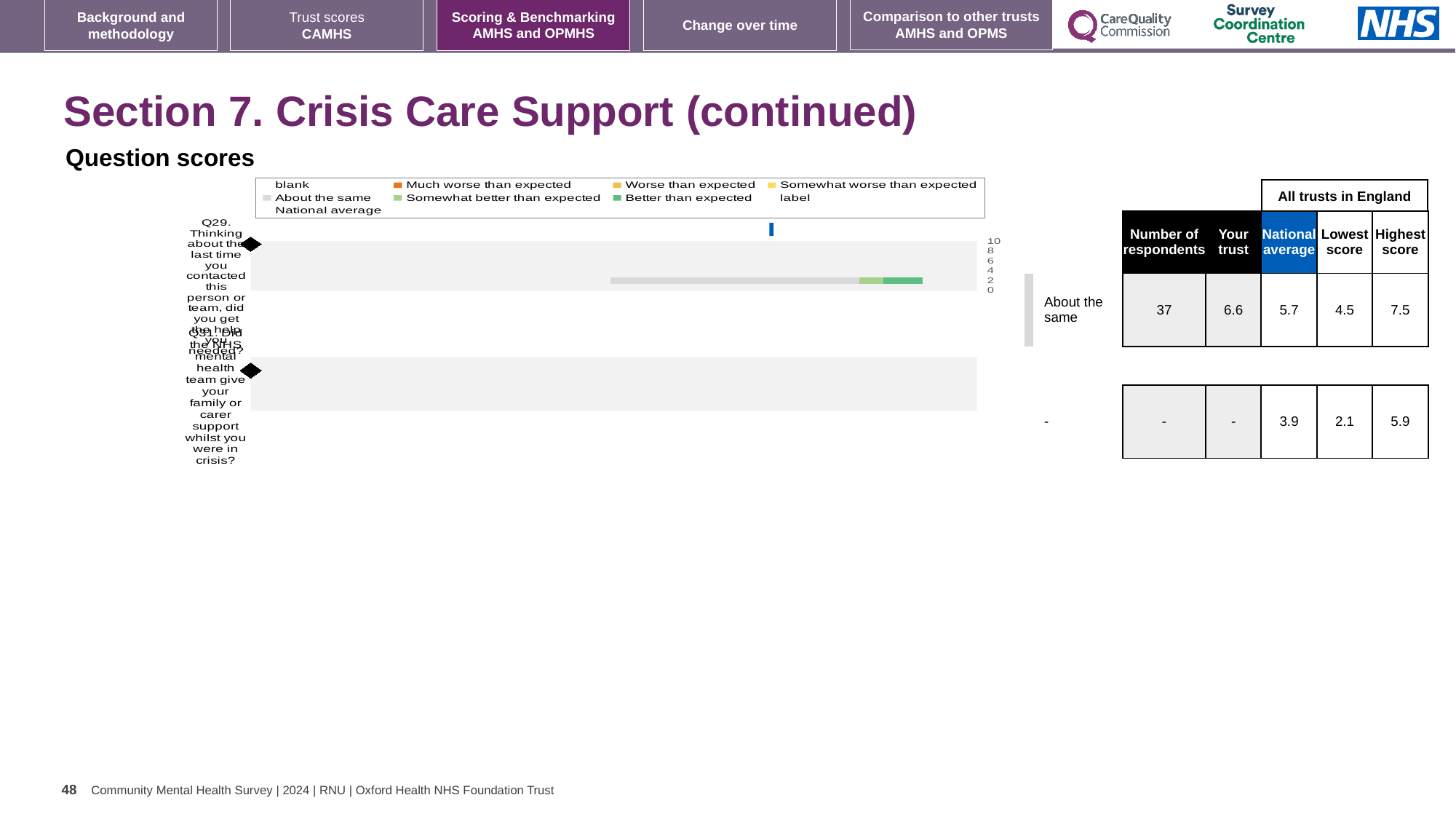
For Q29, is the 'Your trust' score or the national average higher? Your trust Which question has the higher national average, Q29 or Q31? Q29 What is the difference between the highest and lowest trust scores for Q29? 3.0 Which question in the chart is rated 'About the same'? Q29 What is the 'Your trust' score for Q29? 6.6 What is the national average score for Q29? 5.7 How many questions are plotted in the question scores chart? 2 What type of chart is used to show the question scores? bar chart What is the national average score for Q31? 3.9 How many respondents answered Q29? 37 What is the highest score among all trusts in England for Q31? 5.9